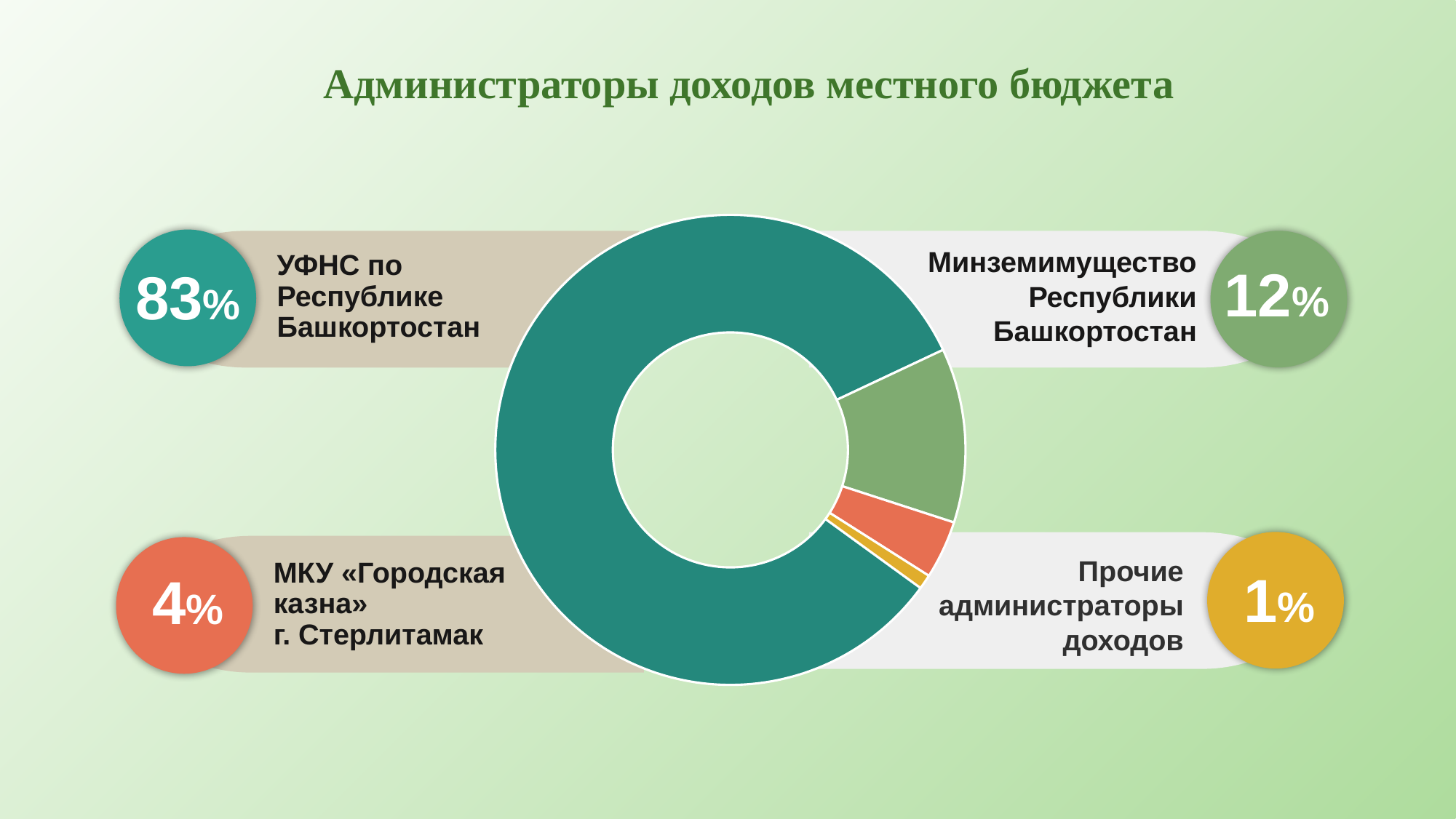
На сколько процентных пунктов доля УФНС по Республике Башкортостан больше доли Минземимущества Республики Башкортостан? 71 Чья доля больше: Минземимущества Республики Башкортостан или МКУ «Городская казна» г. Стерлитамак? Минземимущество Республики Башкортостан Как называется диаграмма на слайде? Администраторы доходов местного бюджета На сколько процентных пунктов доля МКУ «Городская казна» г. Стерлитамак больше доли прочих администраторов доходов? 3 Сколько категорий администраторов доходов показано на диаграмме? 4 Какого типа эта диаграмма? Кольцевая (круговая) диаграмма Какой администратор доходов имеет наибольшую долю? УФНС по Республике Башкортостан Какая доля приходится на МКУ «Городская казна» г. Стерлитамак? 4% Какой администратор доходов имеет наименьшую долю? Прочие администраторы доходов Какая доля приходится на УФНС по Республике Башкортостан? 83% Какая доля приходится на Минземимущество Республики Башкортостан? 12% Какая доля приходится на прочих администраторов доходов? 1%